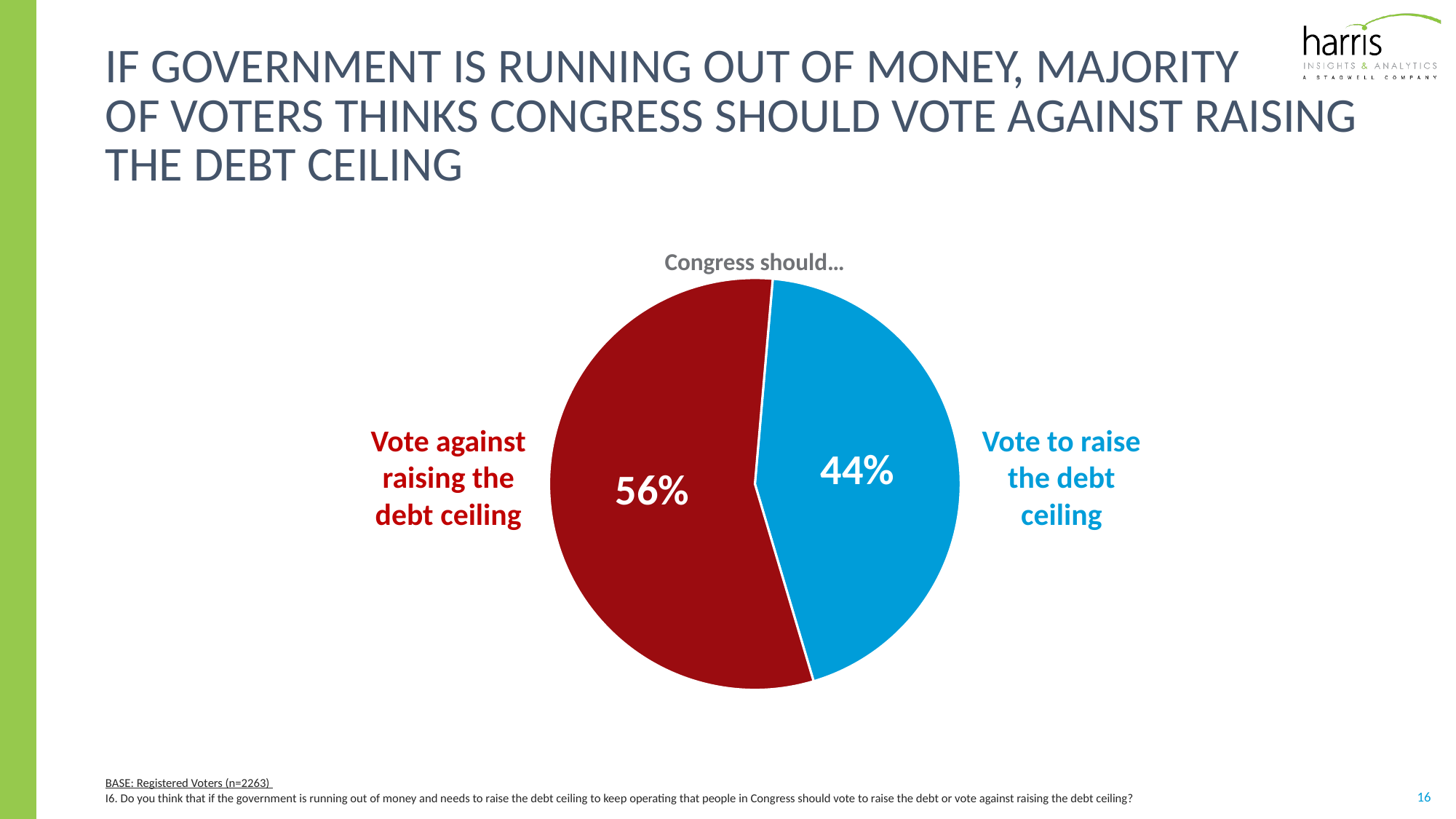
What percentage of voters think Congress should vote to raise the debt ceiling? 44% How many slices does the pie chart have? 2 What kind of chart is shown on the slide? Pie chart What is the total of the two slices shown in the pie chart? 100% Which response has the larger share of the pie? Vote against raising the debt ceiling What colour is the slice for 'Vote to raise the debt ceiling'? Blue What is the difference in percentage points between 'Vote against raising the debt ceiling' and 'Vote to raise the debt ceiling'? 12 Is the share for 'Vote against raising the debt ceiling' greater or less than 50%? greater Is the share for 'Vote to raise the debt ceiling' larger or smaller than the share for 'Vote against raising the debt ceiling'? Smaller What percentage of voters think Congress should vote against raising the debt ceiling? 56% What is the title of the pie chart? Congress should… Which response has the smaller share of the pie? Vote to raise the debt ceiling